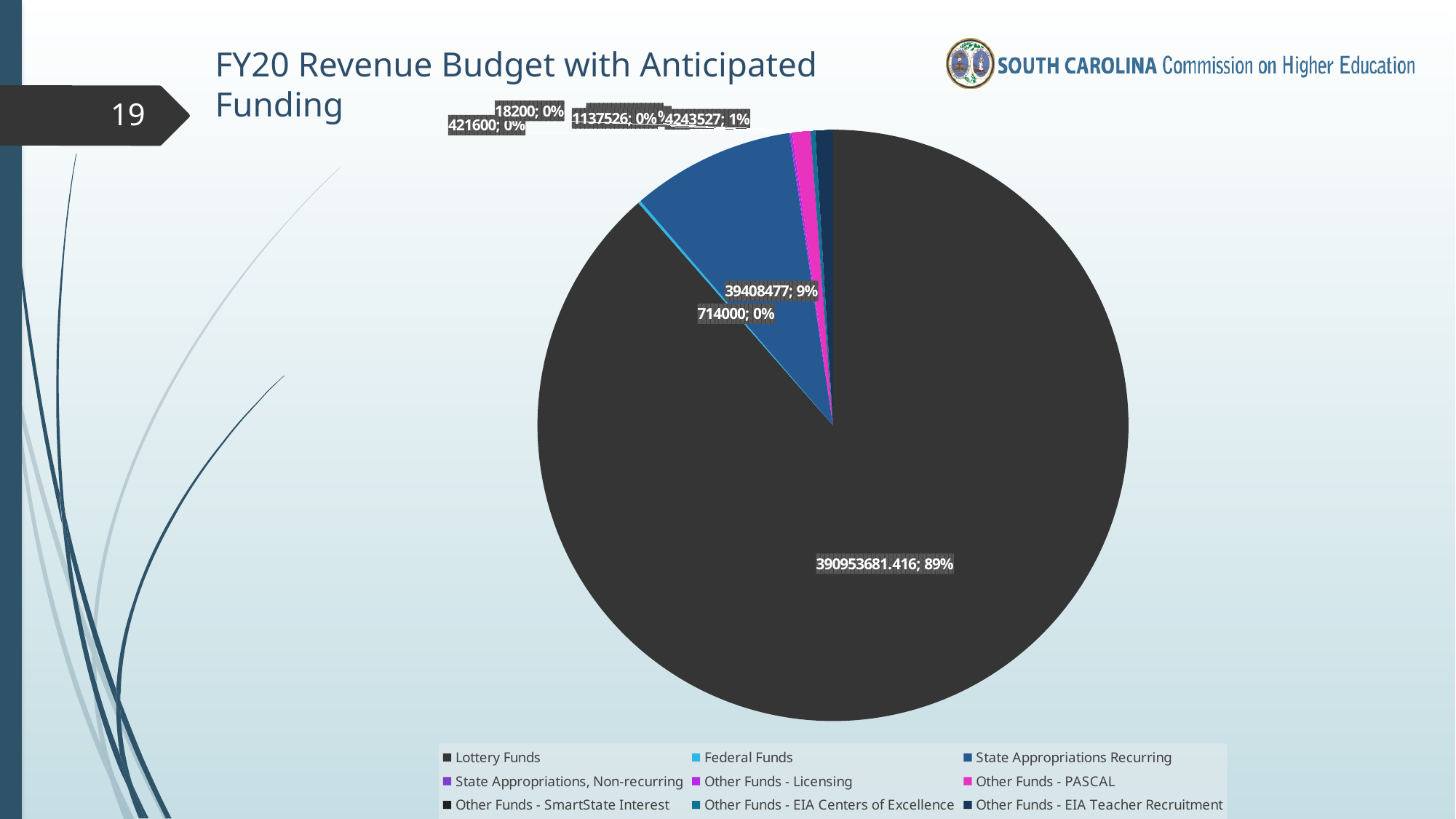
By how many percentage points does the Lottery Funds share exceed the State Appropriations Recurring share? 80 percentage points What is the title of the chart on the slide? FY20 Revenue Budget with Anticipated Funding Is the share of the pie for Lottery Funds greater or less than 50%? greater Which is larger, the Lottery Funds slice or the State Appropriations Recurring slice? Lottery Funds What share of the pie does State Appropriations Recurring account for? 9% How many categories does the legend of the pie chart list? 9 Which legend entry is shown in the first position of the legend? Lottery Funds What value is printed on the Lottery Funds slice? 390953681.416 Which category has the largest slice of the pie? Lottery Funds What value is printed on the State Appropriations Recurring slice? 39408477 What share of the pie does Lottery Funds account for? 89% What kind of chart is shown on the slide? pie chart